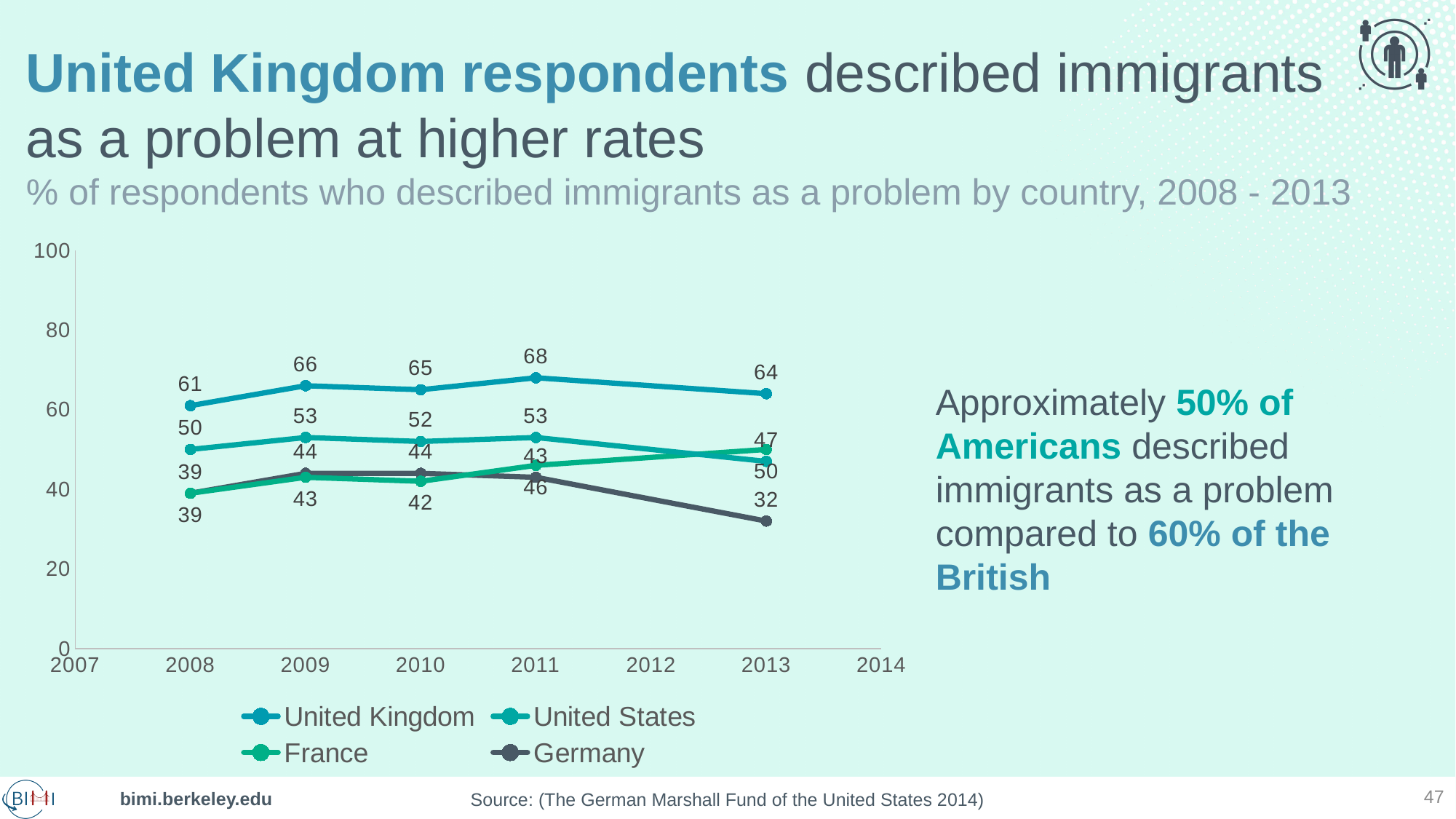
What is the difference between the United Kingdom and United States values in 2013? 17 In which year did the United Kingdom reach its highest value? 2011 How many data points are plotted for the United Kingdom series? 5 What was the value for the United Kingdom in 2011? 68 In 2013, which had the higher value, France or Germany? France Which country had the lowest value in 2013? Germany What was the value for Germany in 2013? 32 Did the value for Germany rise or fall between 2011 and 2013? Fall What was the value for the United States in 2008? 50 Is the value for the United Kingdom in 2009 greater or less than 60? greater How many series does the legend list? 4 What kind of chart is shown on the slide? Line chart